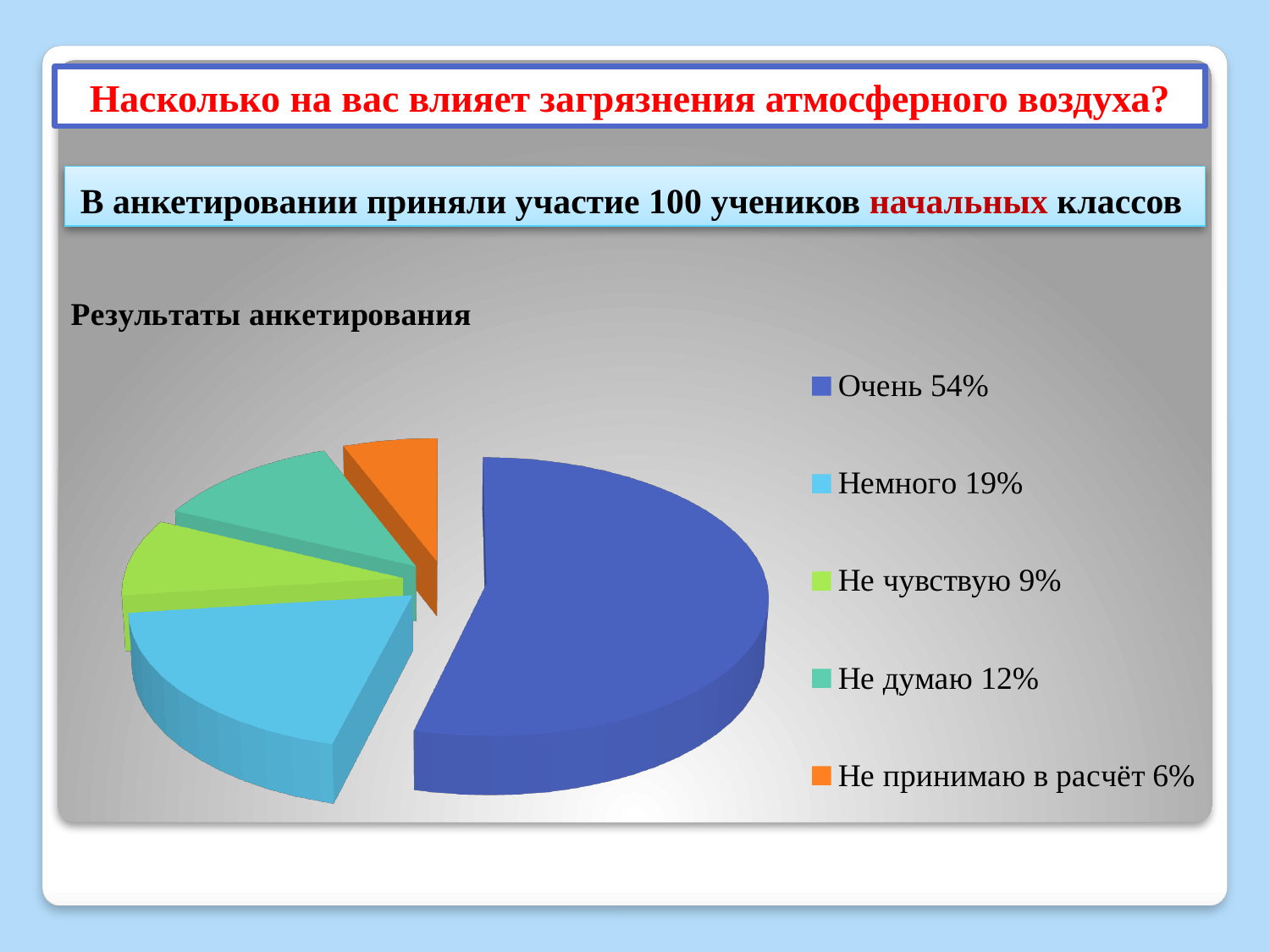
What percentage is shown for "Не принимаю в расчёт"? 6% How many slices does the pie chart have? 5 What percentage is shown for "Не думаю"? 12% What percentage is shown for "Не чувствую"? 9% Which category has the smallest share of the pie? Не принимаю в расчёт What is the chart's title? Результаты анкетирования What percentage is shown for "Немного"? 19% Which is larger, the share for "Не думаю" or the share for "Не чувствую"? Не думаю What is the difference in percentage points between "Очень" and "Немного"? 35 What percentage is shown for "Очень"? 54% Which category has the largest share of the pie? Очень What kind of chart is shown on the slide? Pie chart